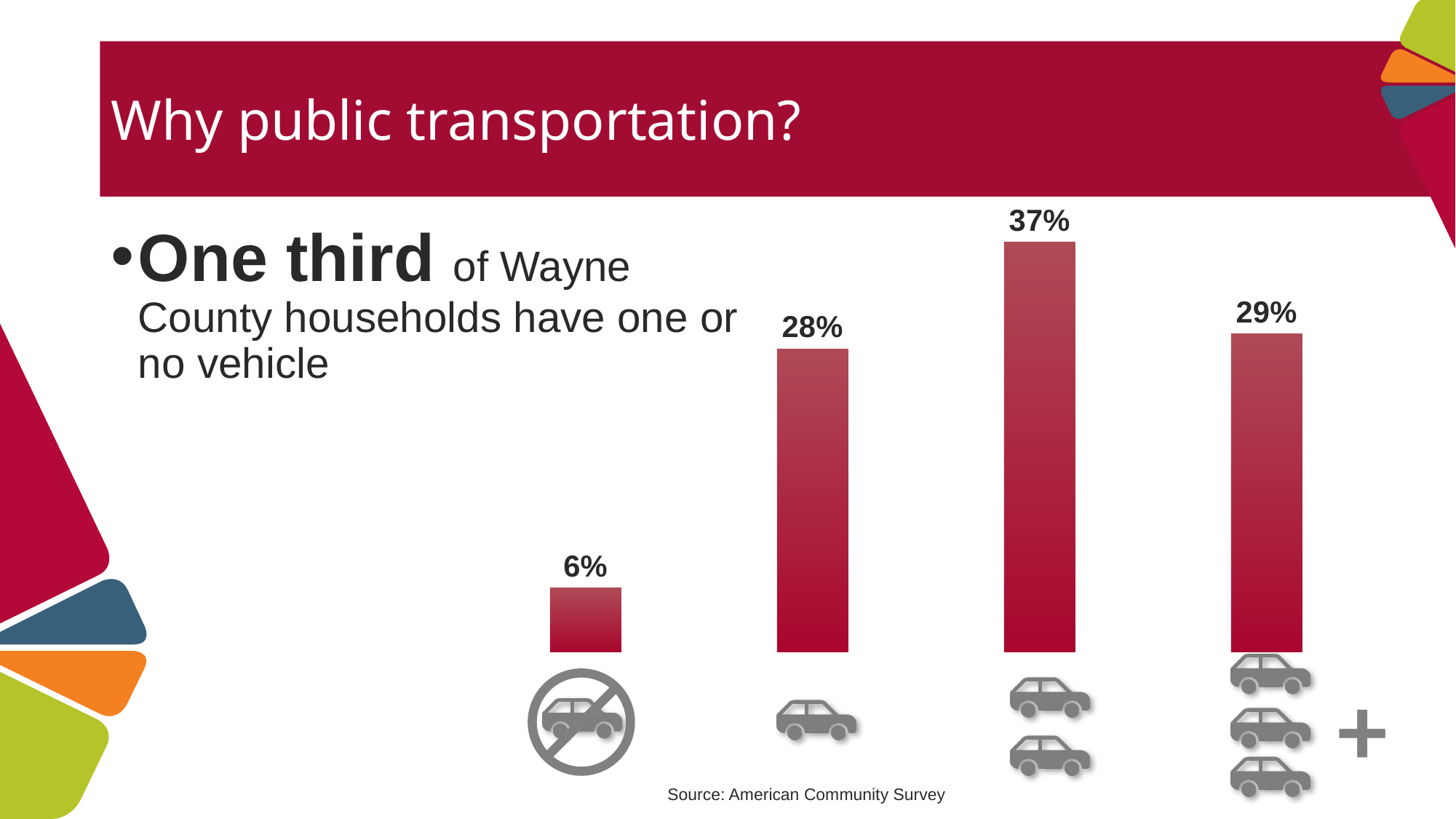
What source is cited for the chart data? American Community Survey Which vehicle category has the lowest percentage of households? No vehicle (6%) Which vehicle category has the highest percentage of households? Two vehicles (37%) What type of chart is shown on the slide? Bar chart What percentage is shown for the bar with two car icons (two vehicles)? 37% What percentage of households is shown for the bar with the crossed-out car icon (no vehicle)? 6% Which is larger, the percentage for one vehicle or the percentage for three or more vehicles? Three or more vehicles (29%) What is the difference in percentage points between the two-vehicle bar and the one-vehicle bar? 9 percentage points What percentage is shown for the bar with a single car icon (one vehicle)? 28% How many bars are shown in the chart? 4 What is the combined percentage of households with no vehicle or one vehicle? 34% What percentage is shown for the bar with three car icons and a plus sign (three or more vehicles)? 29%